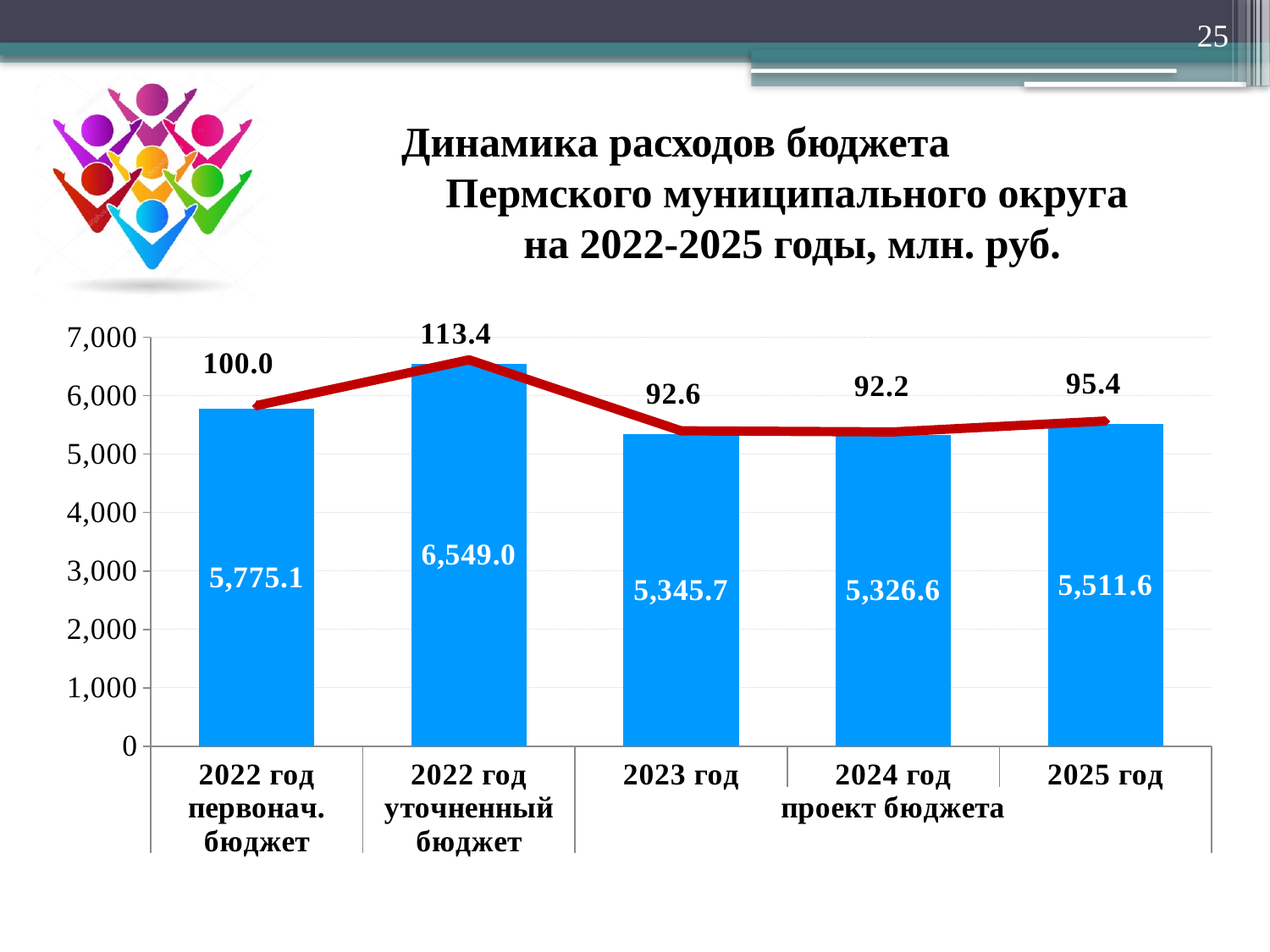
Which category has the highest bar value? 2022 год уточненный бюджет What is the value of the red line for 2023 год? 92.6 What is the bar value for 2024 год? 5,326.6 What unit is stated in the chart title? млн. руб. Which category has the lowest bar value? 2024 год Which is larger, the bar value for 2025 год or for 2023 год? 2025 год What is the bar value for 2022 год уточненный бюджет? 6,549.0 Do the bar values rise or fall from 2023 год to 2025 год? rise Is the bar value for 2022 год первонач. бюджет greater or less than 6,000? less What is the value of the red line for 2025 год? 95.4 What is the difference between the bar values for 2022 год уточненный бюджет and 2022 год первонач. бюджет? 773.9 How many bars are shown in the chart? 5